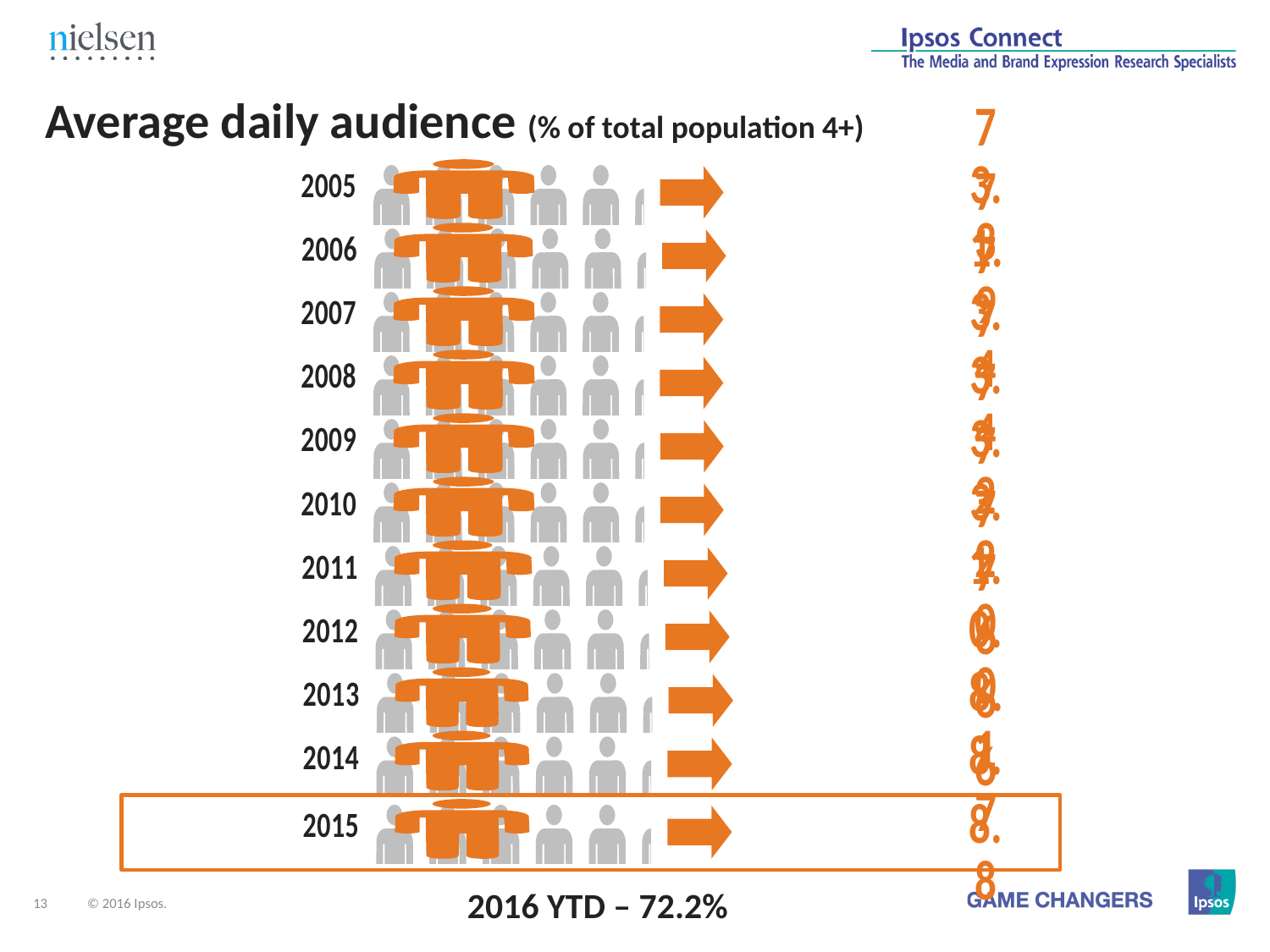
What kind of chart is this? pictograph What value is shown for 2016 YTD? 72.2% How many years are listed in the chart? 11 Which year's row is highlighted with an orange box? 2015 What is the title of the chart? Average daily audience